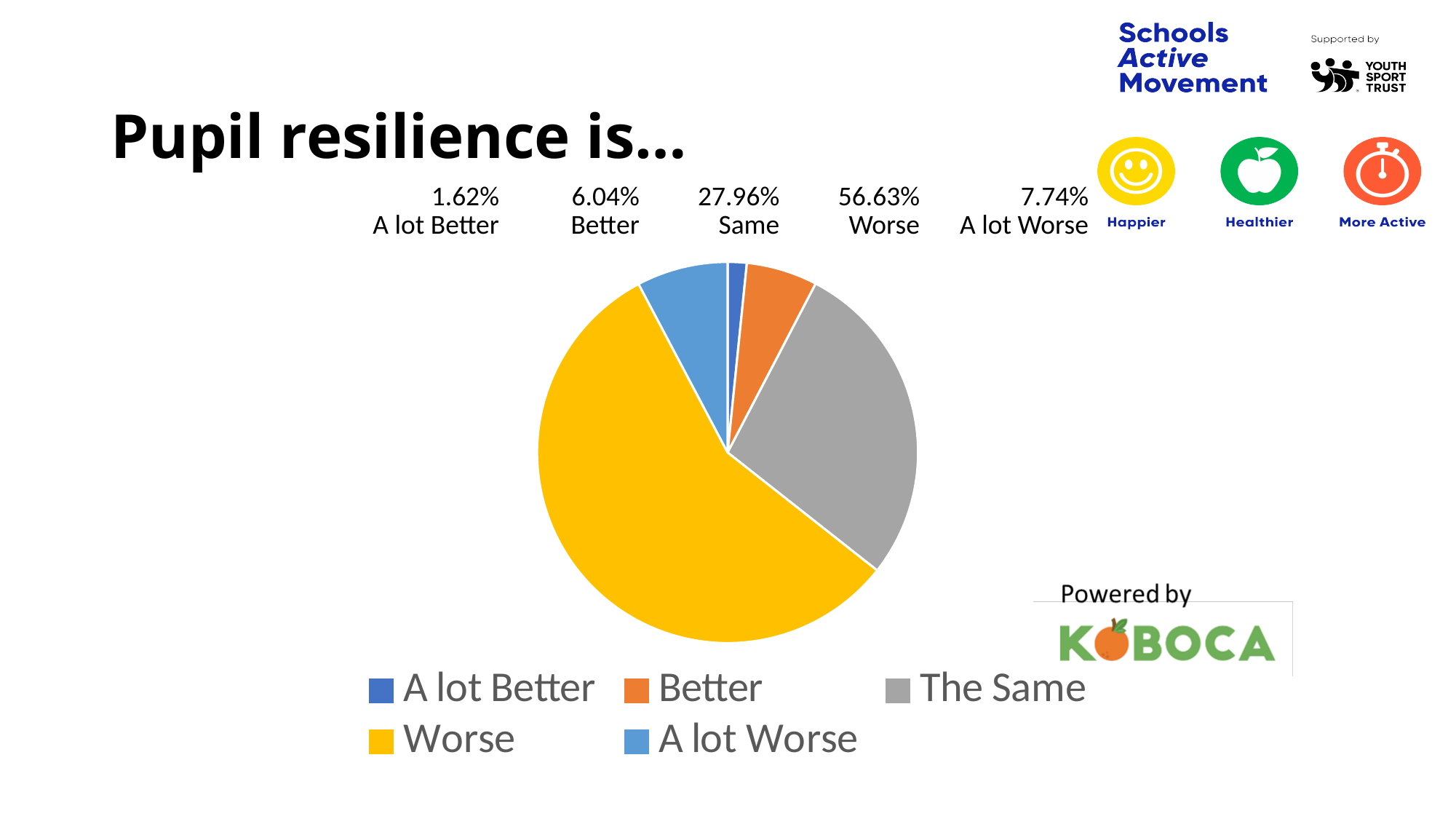
What is the title of the slide containing the chart? Pupil resilience is… What percentage of responses say pupil resilience is A lot Worse? 7.74% What percentage of responses say pupil resilience is A lot Better? 1.62% How many categories does the pie chart have? 5 Which category has the largest share of the pie? Worse What kind of chart is shown on the slide? pie chart Which category has the smallest share of the pie? A lot Better What is the difference in percentage points between Worse and Same? 28.67 What percentage of responses say pupil resilience is the Same? 27.96% Which is larger, the share for Better or the share for A lot Worse? A lot Worse What percentage of responses say pupil resilience is Worse? 56.63% What colour is the Worse slice of the pie? yellow